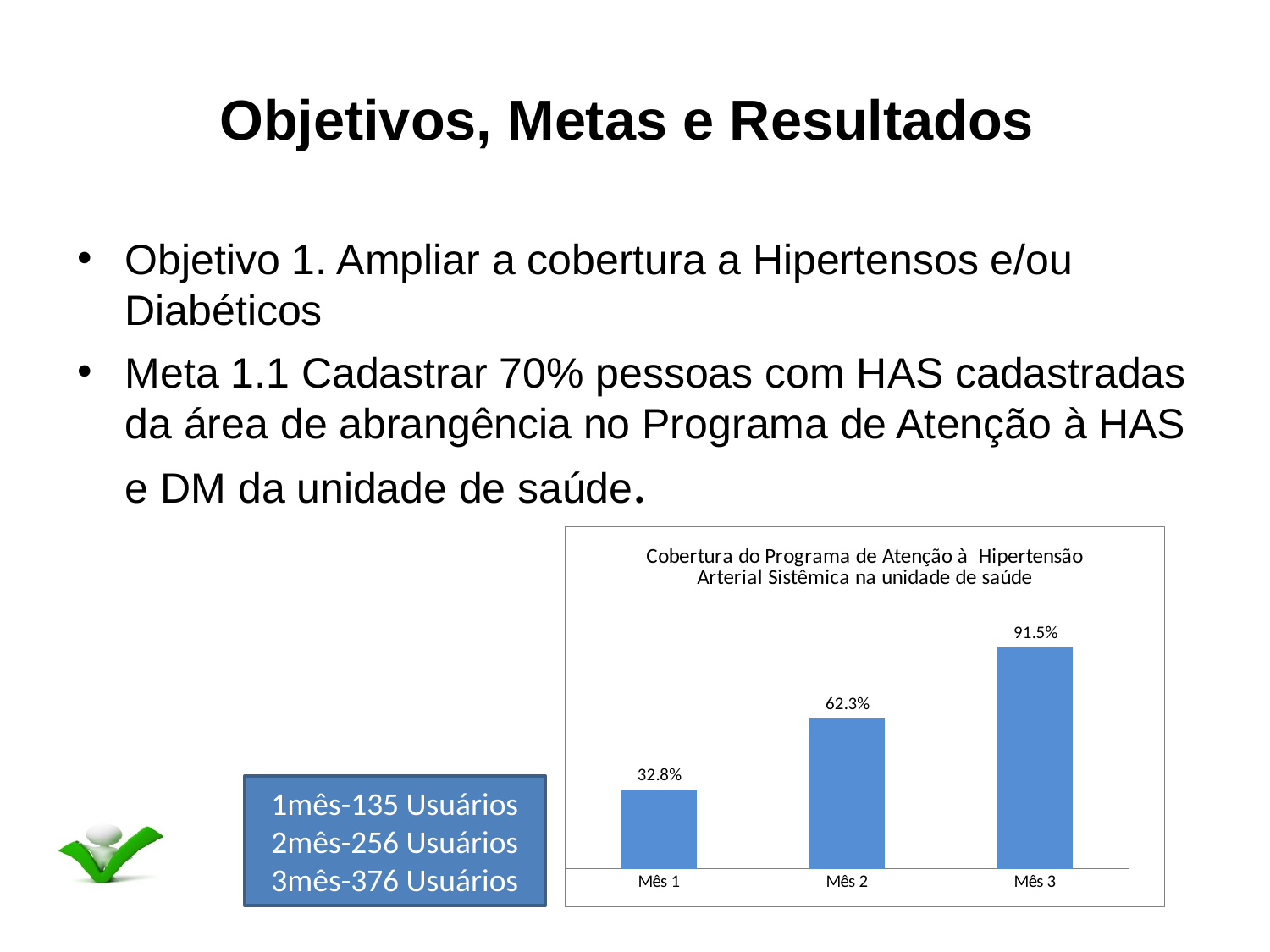
What is the value for Mês 2? 62.3% What kind of chart is shown on the slide? Bar chart Which month has the highest coverage value? Mês 3 What is the difference between the values for Mês 3 and Mês 1? 58.7% Which is larger, the value for Mês 2 or the value for Mês 3? Mês 3 What is the difference between the values for Mês 2 and Mês 1? 29.5% Which month has the lowest coverage value? Mês 1 Do the values rise or fall from Mês 1 to Mês 3? Rise What is the title of the chart? Cobertura do Programa de Atenção à Hipertensão Arterial Sistêmica na unidade de saúde How many categories are shown on the x axis of the chart? 3 What is the value for Mês 1? 32.8% What is the value for Mês 3? 91.5%